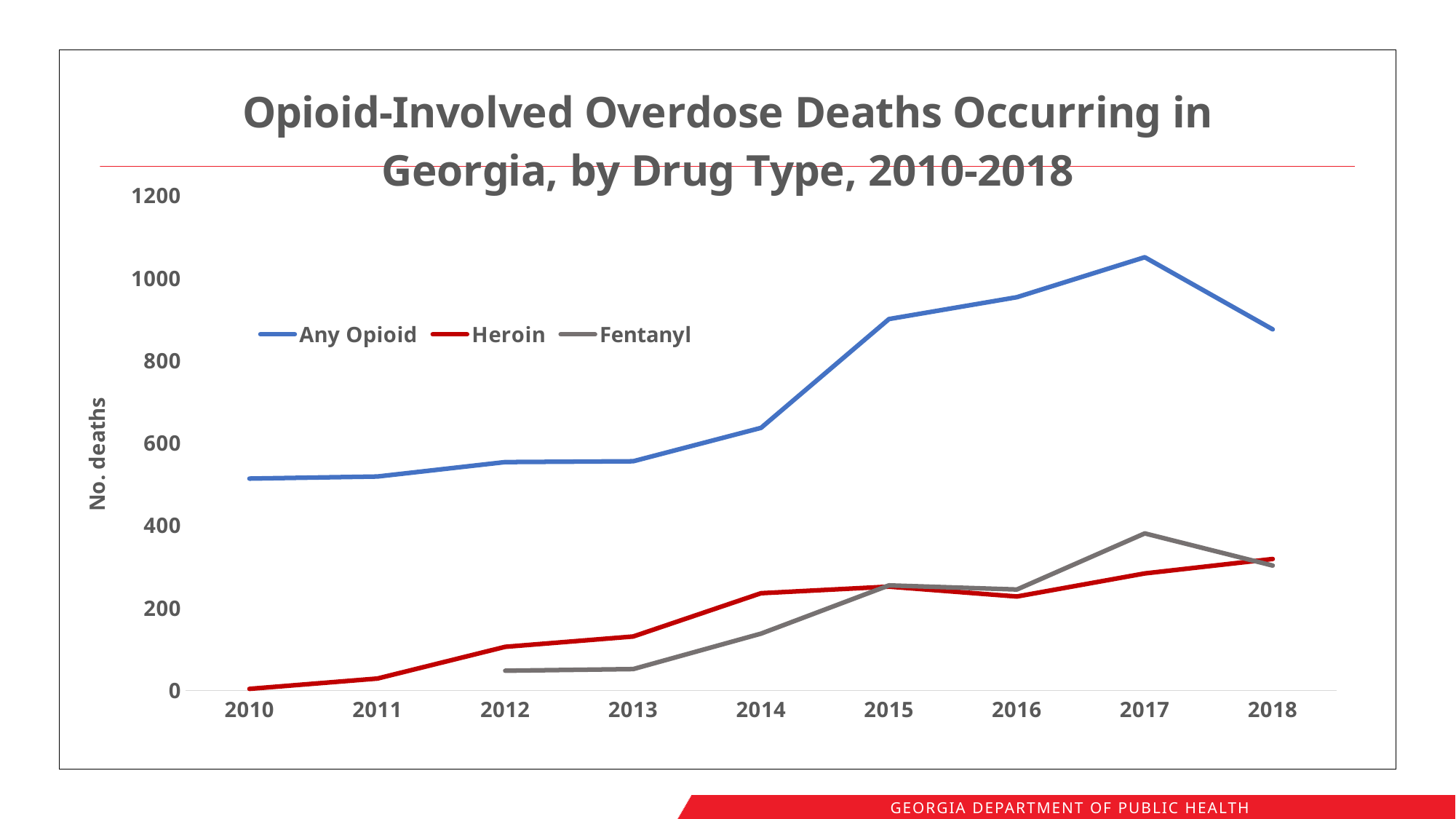
In 2017, which is higher: Heroin or Fentanyl? Fentanyl In which year does the Any Opioid line reach its highest value? 2017 Is the value for Any Opioid in 2018 greater or less than 1000? less Is the value for Heroin in 2010 greater or less than 200? less How many years are shown along the x axis? 9 In 2013, which is higher: Heroin or Fentanyl? Heroin Is the value for Any Opioid in 2017 greater or less than 1000? greater How many series does the legend list? 3 What is the label on the y axis? No. deaths In which year is the Heroin line at its lowest value? 2010 In which year does the Fentanyl line reach its highest value? 2017 What kind of chart is shown on the slide? Line chart